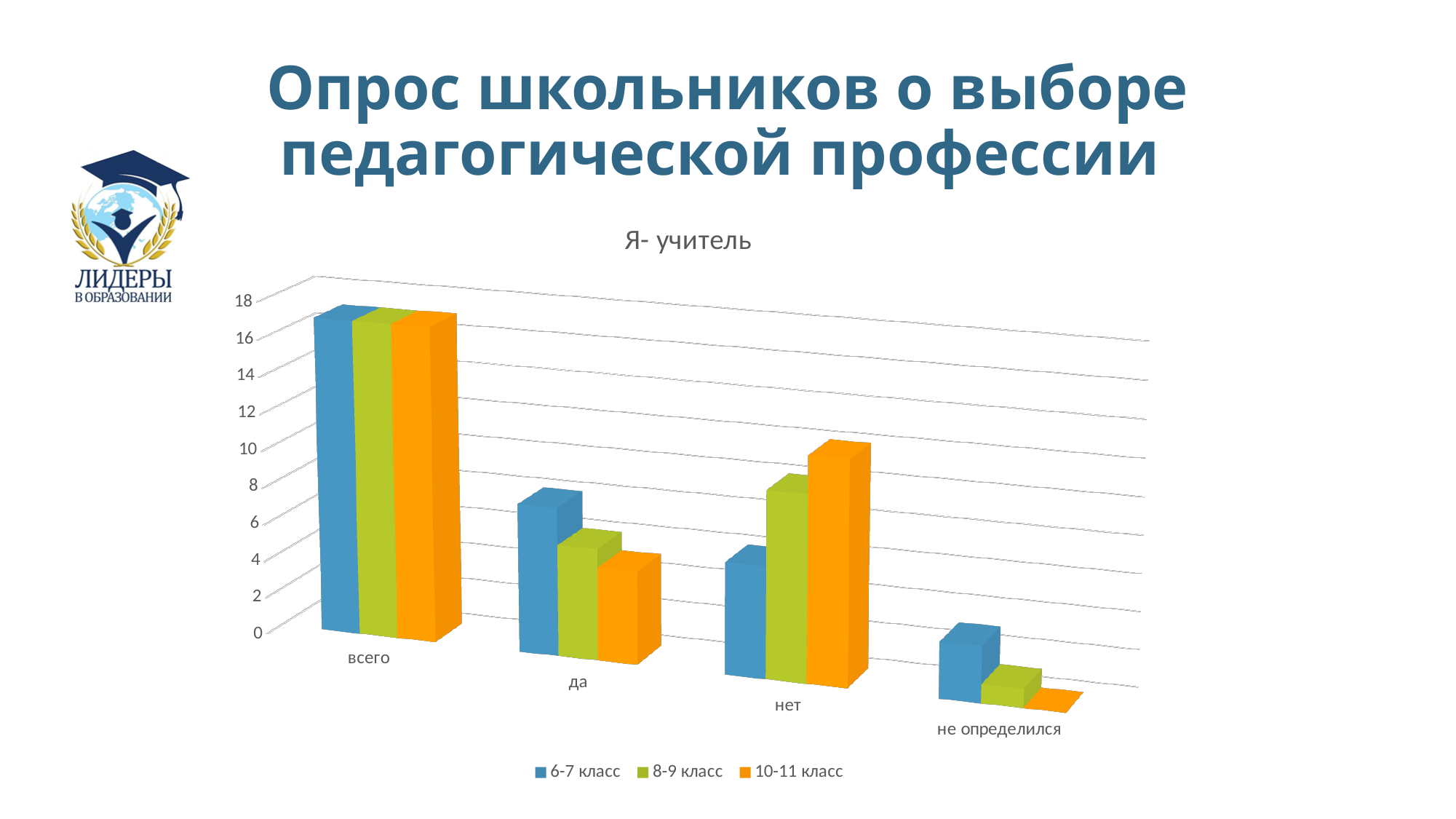
Which series are listed in the legend? 6-7 класс, 8-9 класс, 10-11 класс For the 6-7 класс series, which category has the highest value? всего Is the value for 6-7 класс in the category всего greater or less than 10? greater In the category да, which is larger: 6-7 класс or 10-11 класс? 6-7 класс What kind of chart is shown on the slide? bar chart How many categories are shown on the x axis? 4 In the category не определился, which series has the highest value? 6-7 класс How many series does the legend list? 3 What is the title of the chart? Я- учитель In the category нет, which is larger: 10-11 класс or 6-7 класс? 10-11 класс Is the value for 10-11 класс in the category да greater or less than 10? less For the 10-11 класс series, which category has the lowest value? не определился